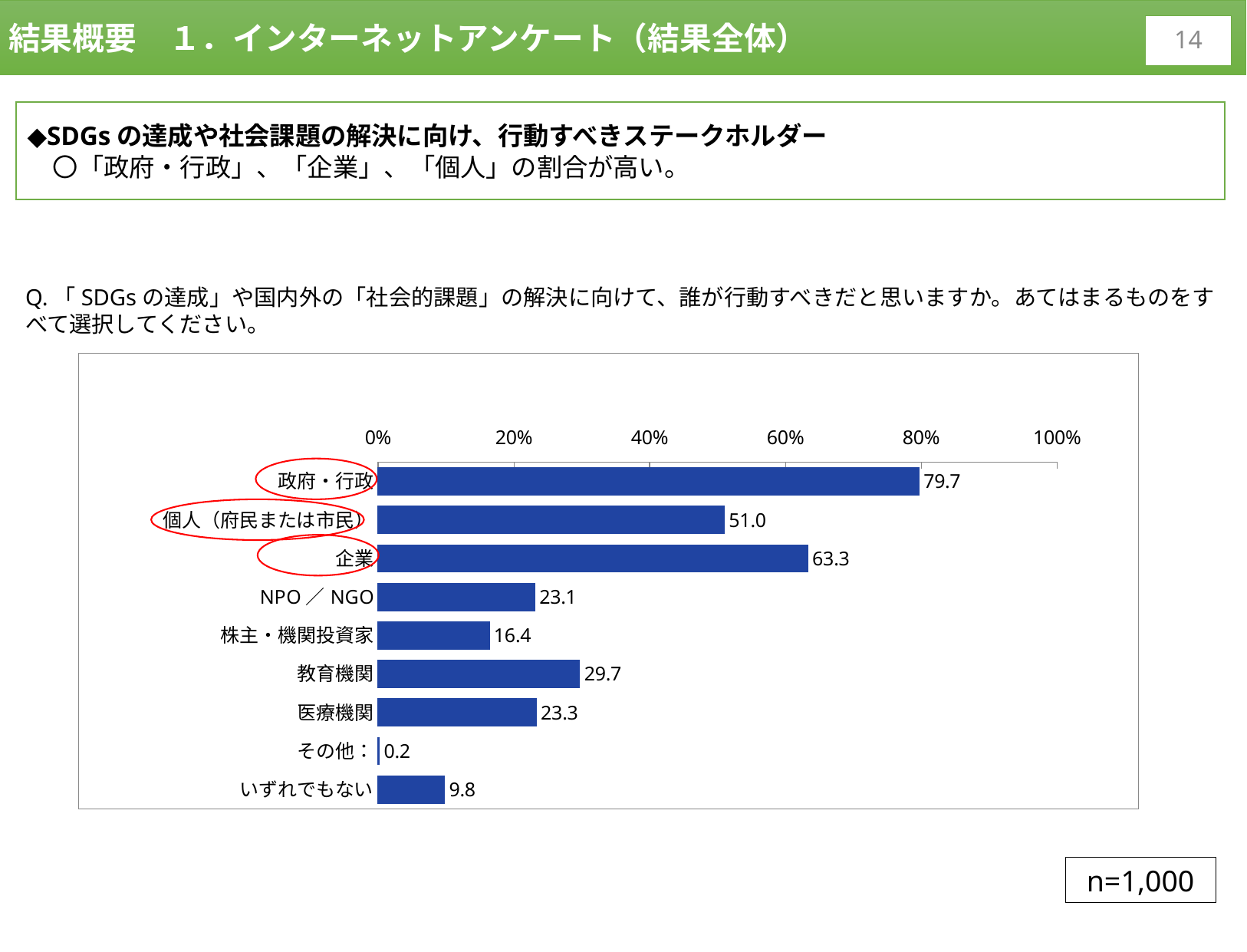
Which category has the highest value? 政府・行政 What is the value for いずれでもない? 9.8 Is the value for 株主・機関投資家 greater or less than 20%? less What sample size is shown next to the chart? n=1,000 What is the value for 企業? 63.3 Which is larger, the value for 個人（府民または市民） or the value for 企業? 企業 Which category has the lowest value? その他： What is the value for 教育機関? 29.7 What is the difference between the values for 政府・行政 and 企業? 16.4 What is the value for 政府・行政? 79.7 What kind of chart is shown on the slide? bar chart How many categories are shown in the chart? 9